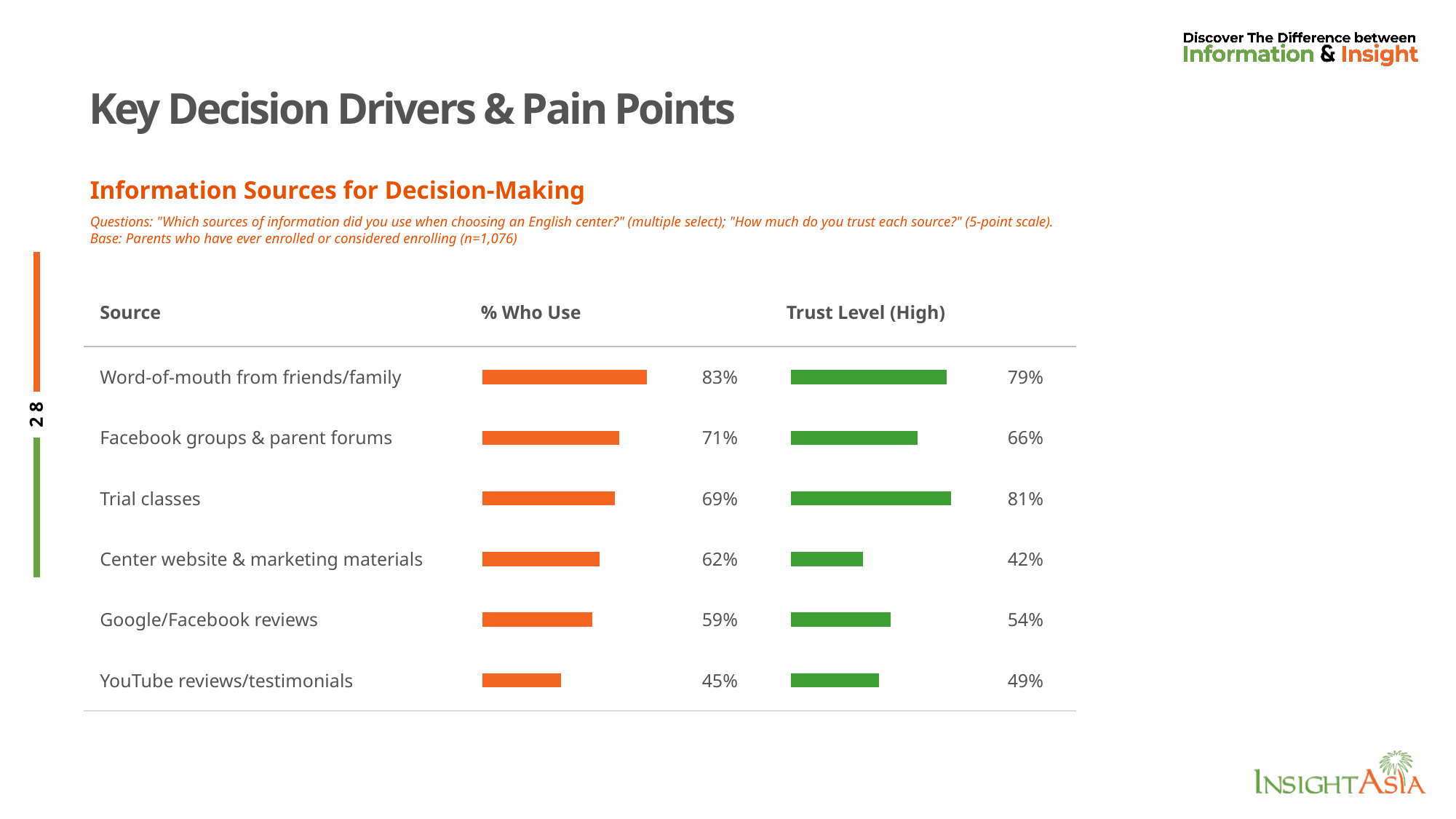
What is the % Who Use value for Word-of-mouth from friends/family? 83% What is the Trust Level (High) value for Trial classes? 81% Which source has the highest % Who Use? Word-of-mouth from friends/family What is the difference between the % Who Use for Word-of-mouth from friends/family and for YouTube reviews/testimonials? 38% What colour are the bars in the Trust Level (High) column? Green What is the difference between the Trust Level (High) for Trial classes and for Center website & marketing materials? 39% What is the Trust Level (High) value for Center website & marketing materials? 42% How many sources are listed in the chart? 6 Which source has the lowest Trust Level (High)? Center website & marketing materials Which is larger for Google/Facebook reviews: % Who Use or Trust Level (High)? % Who Use Which source has the highest Trust Level (High)? Trial classes What kind of chart is used to show the values? Bar chart